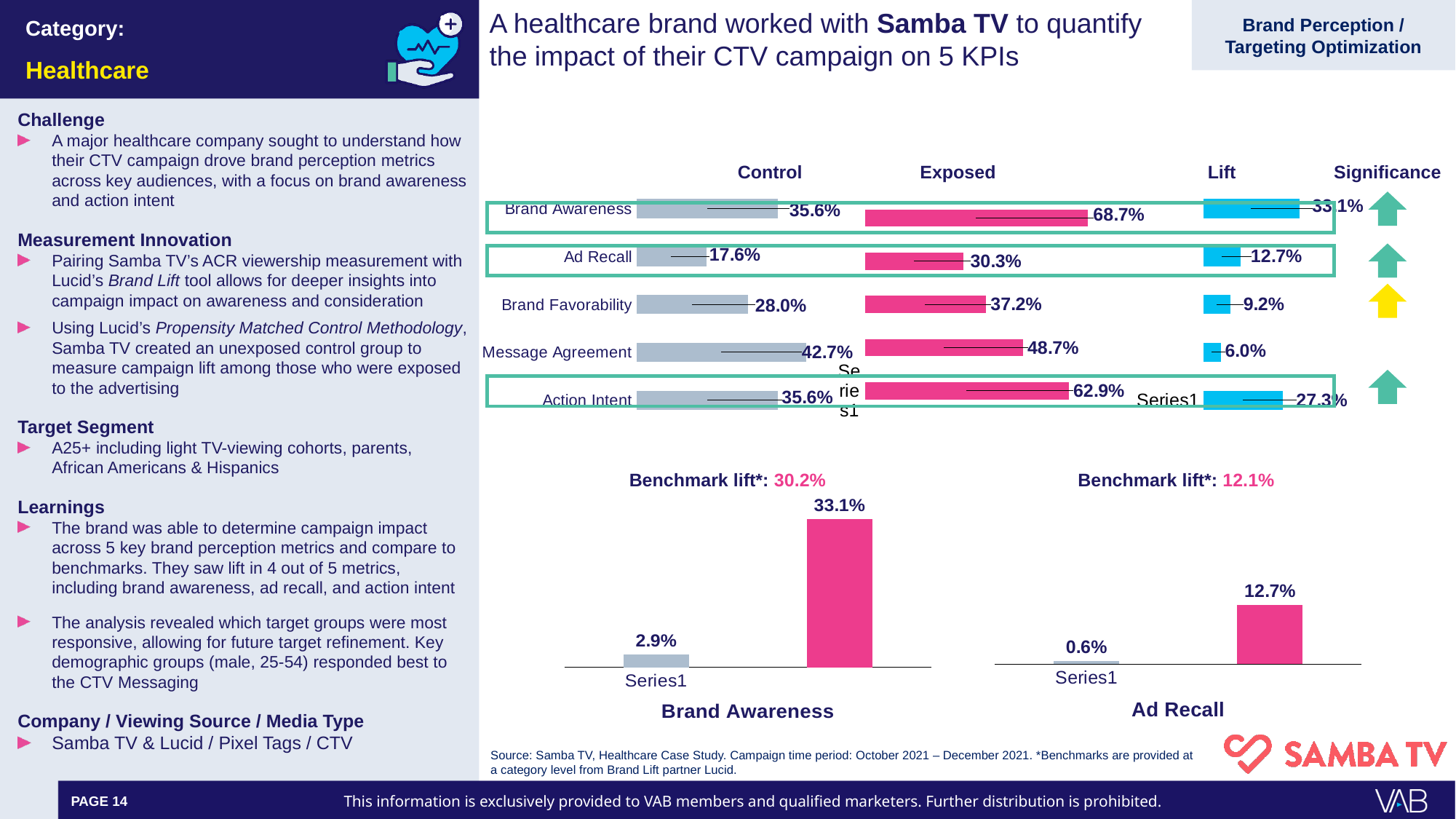
In the top chart, what is the Lift value for Message Agreement? 6.0% In the top chart, which is larger: the Exposed value for Brand Favorability or the Exposed value for Message Agreement? Message Agreement In the top chart, which KPI has the lowest Control value? Ad Recall In the top chart, what is the difference between the Exposed and Control values for Action Intent? 27.3% In the bottom-left Brand Awareness chart, what is the value of the grey bar? 2.9% In the top chart, what is the Control value for Ad Recall? 17.6% In the bottom-right Ad Recall chart, what is the value of the pink bar? 12.7% What type of chart is the bottom-left Brand Awareness chart? Bar chart In the bottom-right Ad Recall chart, what is the difference between the pink bar and the grey bar? 12.1% In the top chart, what is the Exposed value for Brand Awareness? 68.7% In the top chart, which KPI has the highest Lift value? Brand Awareness How many KPIs are listed in the top chart? 5